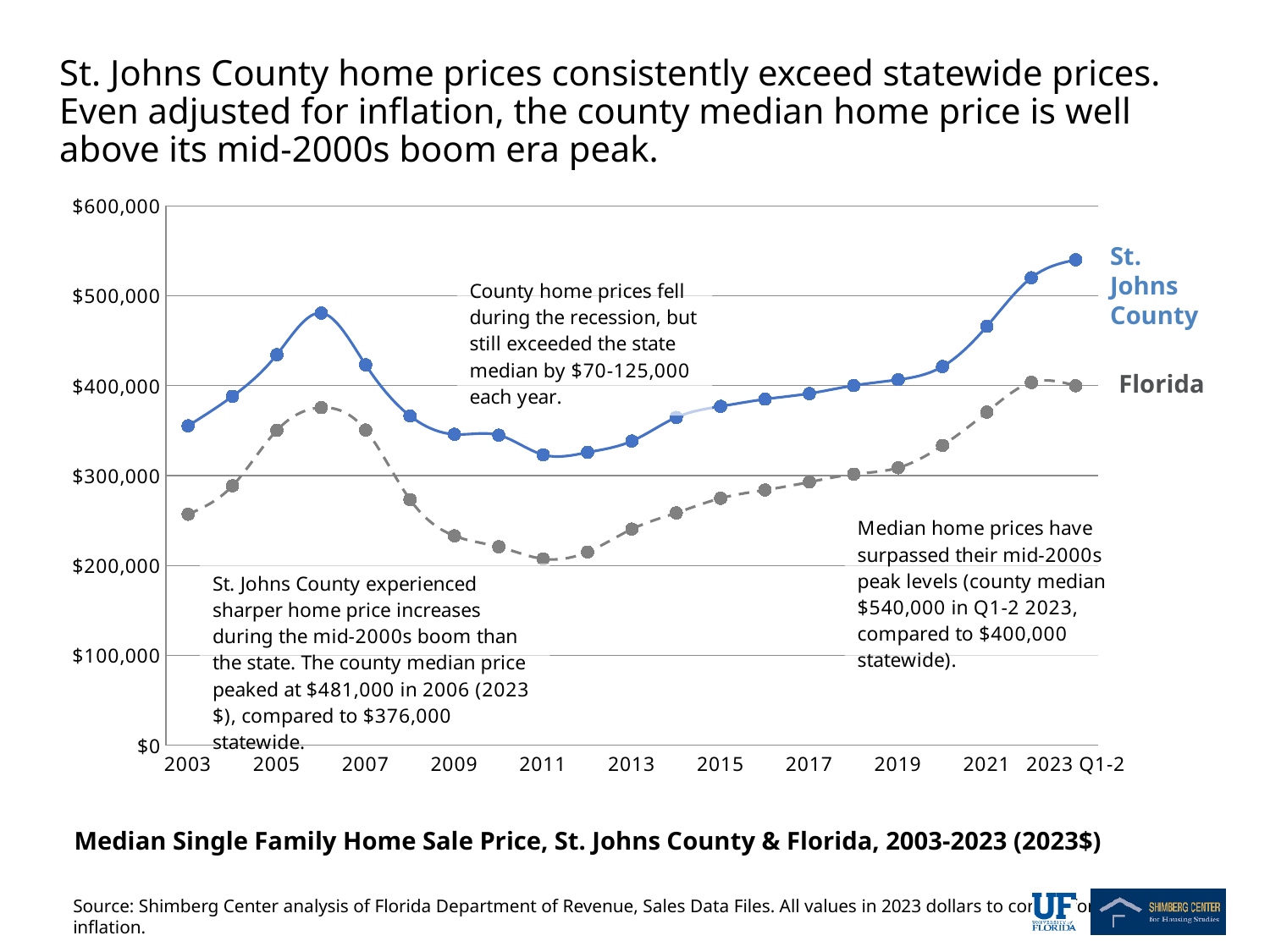
According to the annotation, what was the statewide median home price in 2006 (2023 $)? $376,000 Which series is higher in 2006, St. Johns County or Florida? St. Johns County How many yearly data points does each line have, from 2003 through 2023 Q1-2? 21 At which point does the St. Johns County line reach its highest value? 2023 Q1-2 According to the annotation, what was the St. Johns County median home price in Q1-2 2023? $540,000 How many series are plotted on the chart? 2 What kind of chart is shown on the slide? line chart In which year does the St. Johns County line reach its lowest value? 2011 According to the annotation, what was the St. Johns County median home price at its 2006 peak (2023 $)? $481,000 What is the difference between the St. Johns County median ($540,000) and the statewide median ($400,000) in Q1-2 2023? $140,000 Is the St. Johns County value for 2022 greater or less than $500,000? greater Is the Florida value for 2011 greater or less than $300,000? less